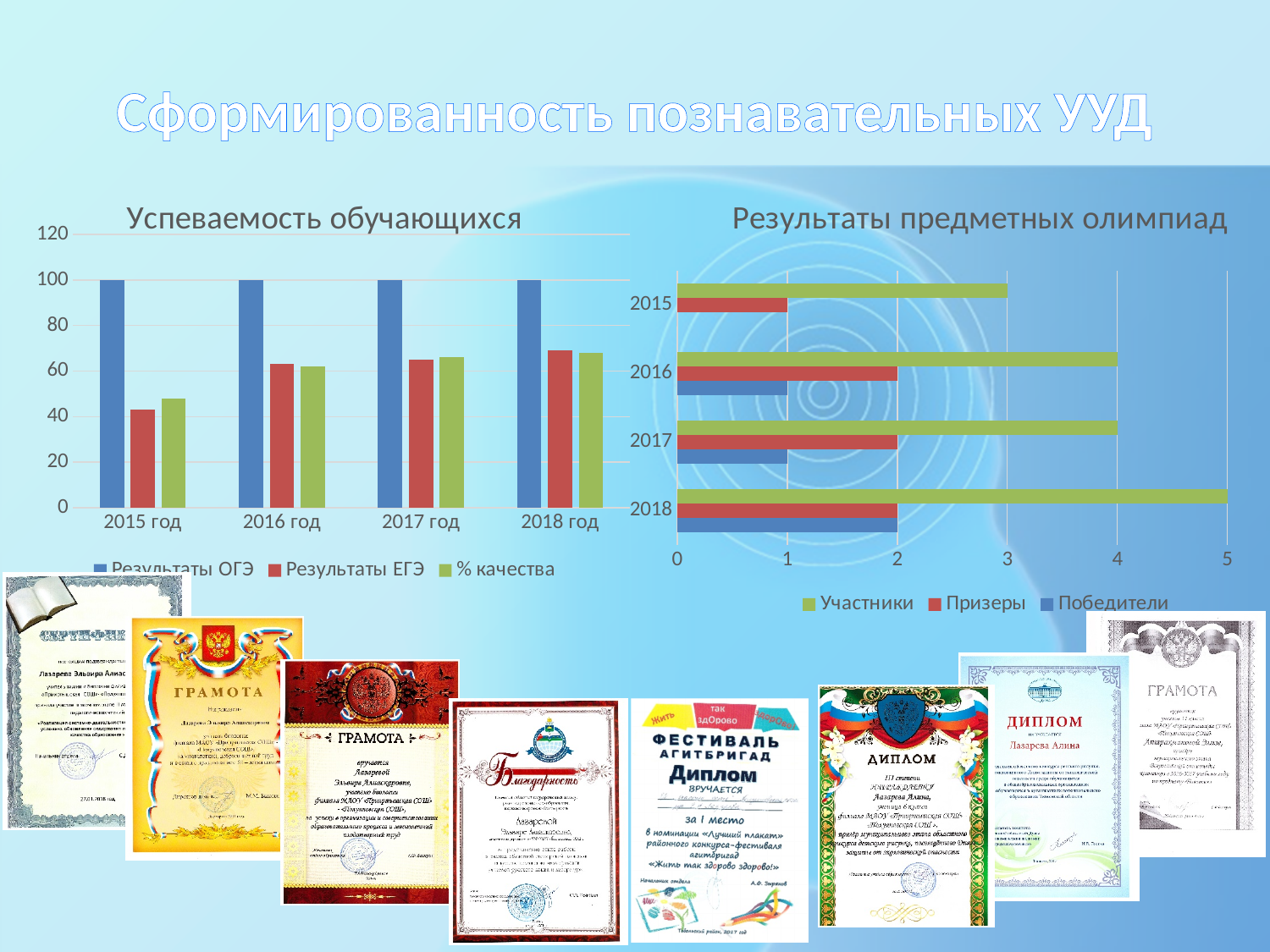
In the 'Результаты предметных олимпиад' chart, how many year categories are shown? 4 In the 'Результаты предметных олимпиад' chart, what is the value of Призеры for 2015? 1 In the 'Успеваемость обучающихся' chart, how many series does the legend list? 3 In the 'Результаты предметных олимпиад' chart, what is the value of Участники for 2018? 5 In the 'Результаты предметных олимпиад' chart, what is the difference between Участники in 2018 and Участники in 2015? 2 In the 'Результаты предметных олимпиад' chart, which year has the highest number of Участники? 2018 In the 'Успеваемость обучающихся' chart, is the value of Результаты ЕГЭ for 2015 год greater or less than 60? less In the 'Успеваемость обучающихся' chart, is the value of % качества for 2018 год greater or less than 60? greater In the 'Результаты предметных олимпиад' chart, which colour represents Победители? blue In the 'Успеваемость обучающихся' chart, which year has the lowest Результаты ЕГЭ value? 2015 год What type of chart is 'Успеваемость обучающихся'? bar chart In the 'Успеваемость обучающихся' chart, what is the value of Результаты ОГЭ for 2015 год? 100